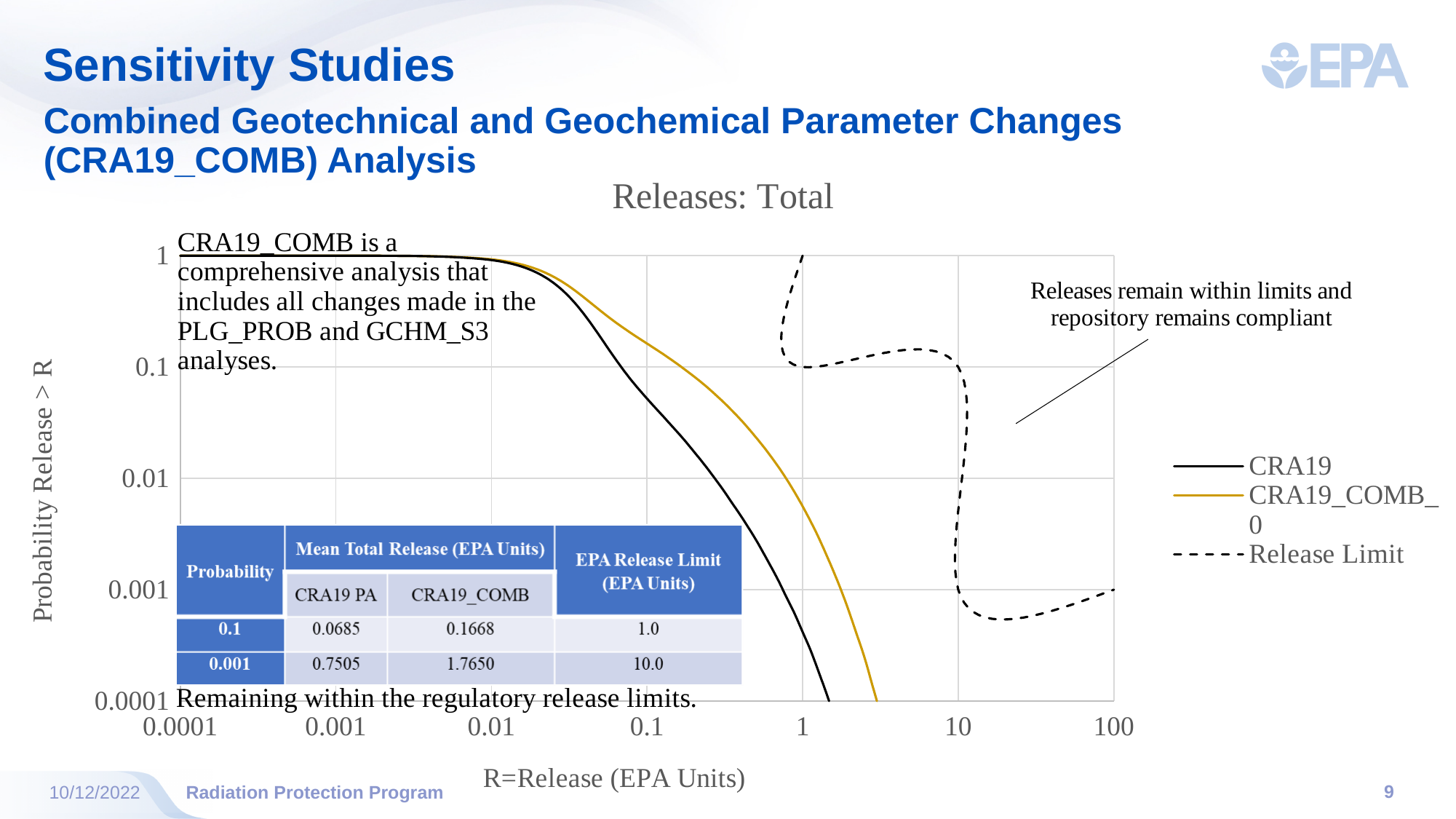
What type of chart is shown on the slide? line chart According to the table on the chart, what is the EPA Release Limit (EPA Units) at probability 0.1? 1.0 At a release of 0.01 EPA units, is the probability for the CRA19 curve greater or less than 0.1? greater How many series does the chart legend list? 3 At a release of 0.1 EPA units, which curve is higher: CRA19 or CRA19_COMB_0? CRA19_COMB_0 What is the label of the y axis of the chart? Probability Release > R What is the label of the x axis of the chart? R=Release (EPA Units) What is the title of the chart? Releases: Total At a release of 1 EPA unit, is the probability for the CRA19 curve greater or less than 0.001? less Do the CRA19 and CRA19_COMB_0 curves rise or fall as the release R increases along the x axis? fall Which series is drawn with a dashed line in the chart? Release Limit According to the table on the chart, what is the mean total release for CRA19_COMB at probability 0.001? 1.7650